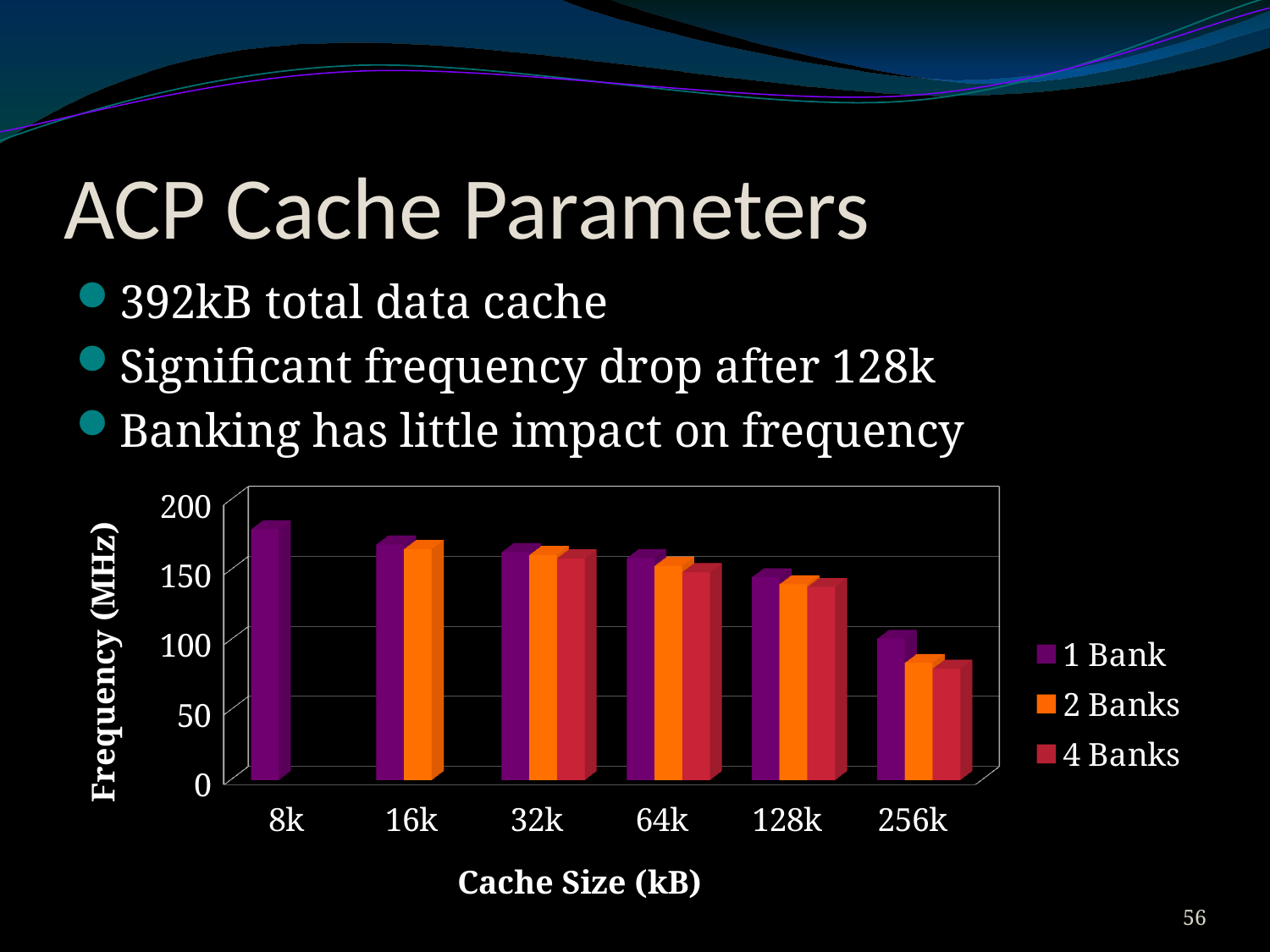
Which is larger for the 1 Bank series: the frequency at 8k or at 256k? 8k What is the label of the y axis? Frequency (MHz) Do the 1 Bank frequencies rise or fall as cache size increases along the x axis? fall Which cache size has the lowest frequency for the 2 Banks series? 256k How many series does the legend list? 3 Which cache size has the highest frequency for the 1 Bank series? 8k Is the 1 Bank frequency at 8k greater or less than 150? greater Which cache size has the lowest frequency for the 1 Bank series? 256k What kind of chart is shown on the slide? bar chart How many cache size categories are shown on the x axis? 6 Is the 2 Banks frequency at 256k greater or less than 100? less Is the 1 Bank frequency at 256k greater or less than 150? less